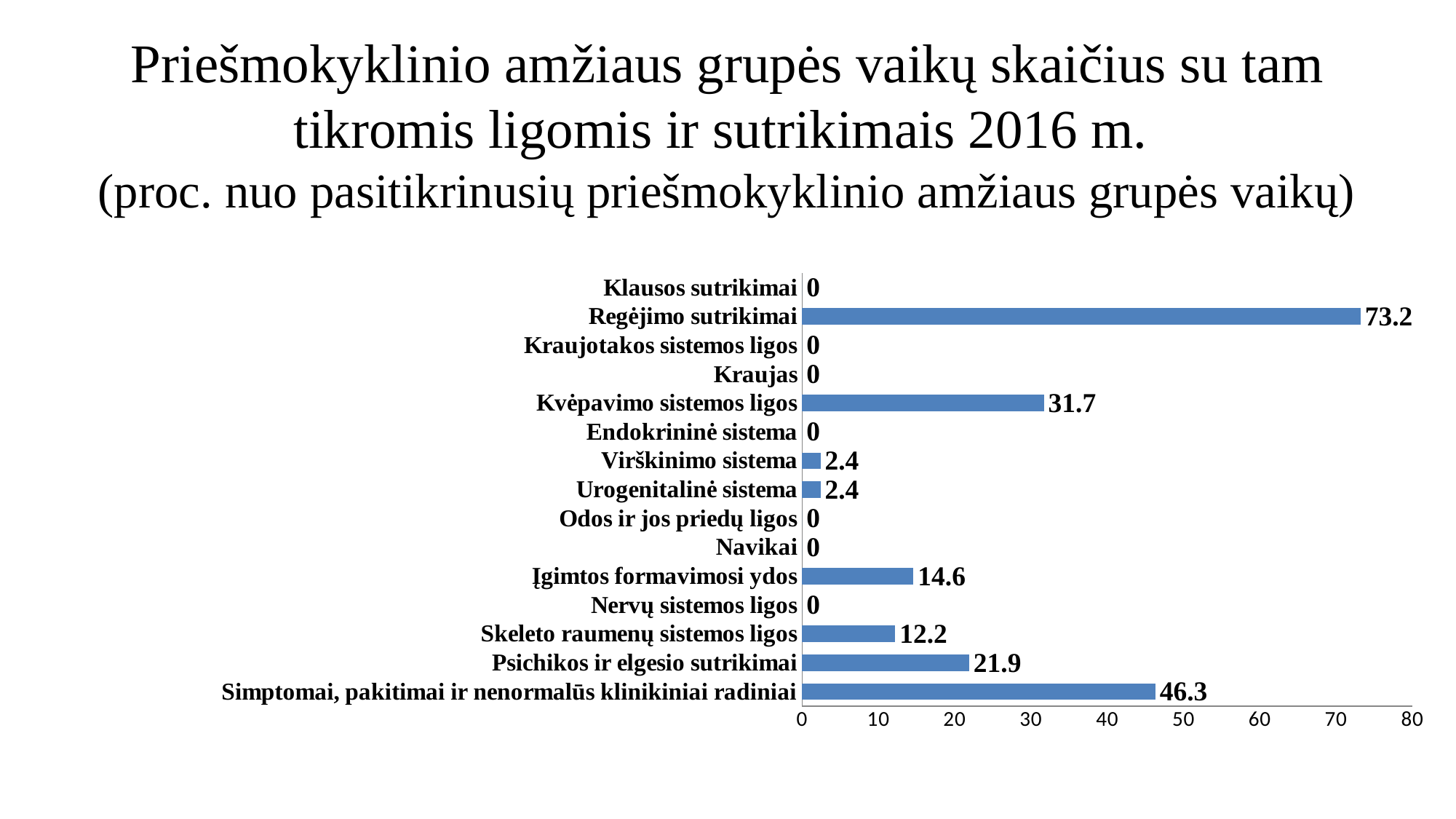
Which is larger, the value for Skeleto raumenų sistemos ligos or the value for Psichikos ir elgesio sutrikimai? Psichikos ir elgesio sutrikimai What is the value for Psichikos ir elgesio sutrikimai? 21.9 What is the difference between the values for Regėjimo sutrikimai and Simptomai, pakitimai ir nenormalūs klinikiniai radiniai? 26.9 What is the value for Įgimtos formavimosi ydos? 14.6 What is the value for Simptomai, pakitimai ir nenormalūs klinikiniai radiniai? 46.3 What is the value for Kvėpavimo sistemos ligos? 31.7 What is the value for Regėjimo sutrikimai? 73.2 Is the value for Kvėpavimo sistemos ligos greater or less than 40? less What kind of chart is shown on the slide? bar chart How many categories are shown on the chart? 15 Which category has the highest value? Regėjimo sutrikimai What is the value for Virškinimo sistema? 2.4